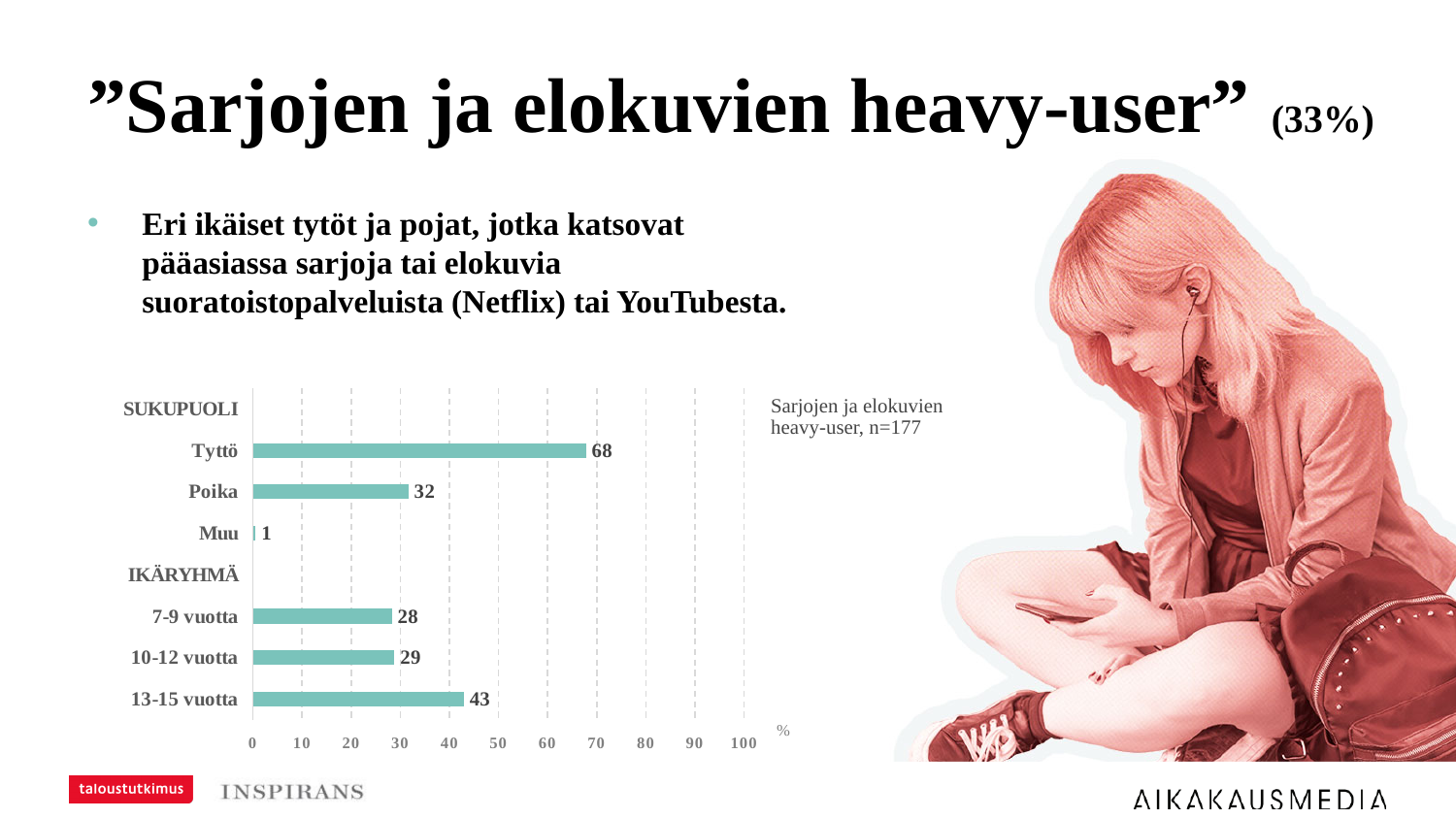
Which is larger, the value for 10-12 vuotta or 13-15 vuotta? 13-15 vuotta What is the value for 7-9 vuotta? 28 What is the value for Poika? 32 Which category has the lowest value? Muu How many bars are plotted in the chart? 6 What kind of chart is shown on the slide? bar chart What is the sample size (n) stated next to the chart? n=177 What is the difference between the values for Tyttö and Poika? 36 What is the value for Tyttö? 68 What is the value for 13-15 vuotta? 43 Which category has the highest value? Tyttö Is the value for Tyttö greater or less than 60? greater